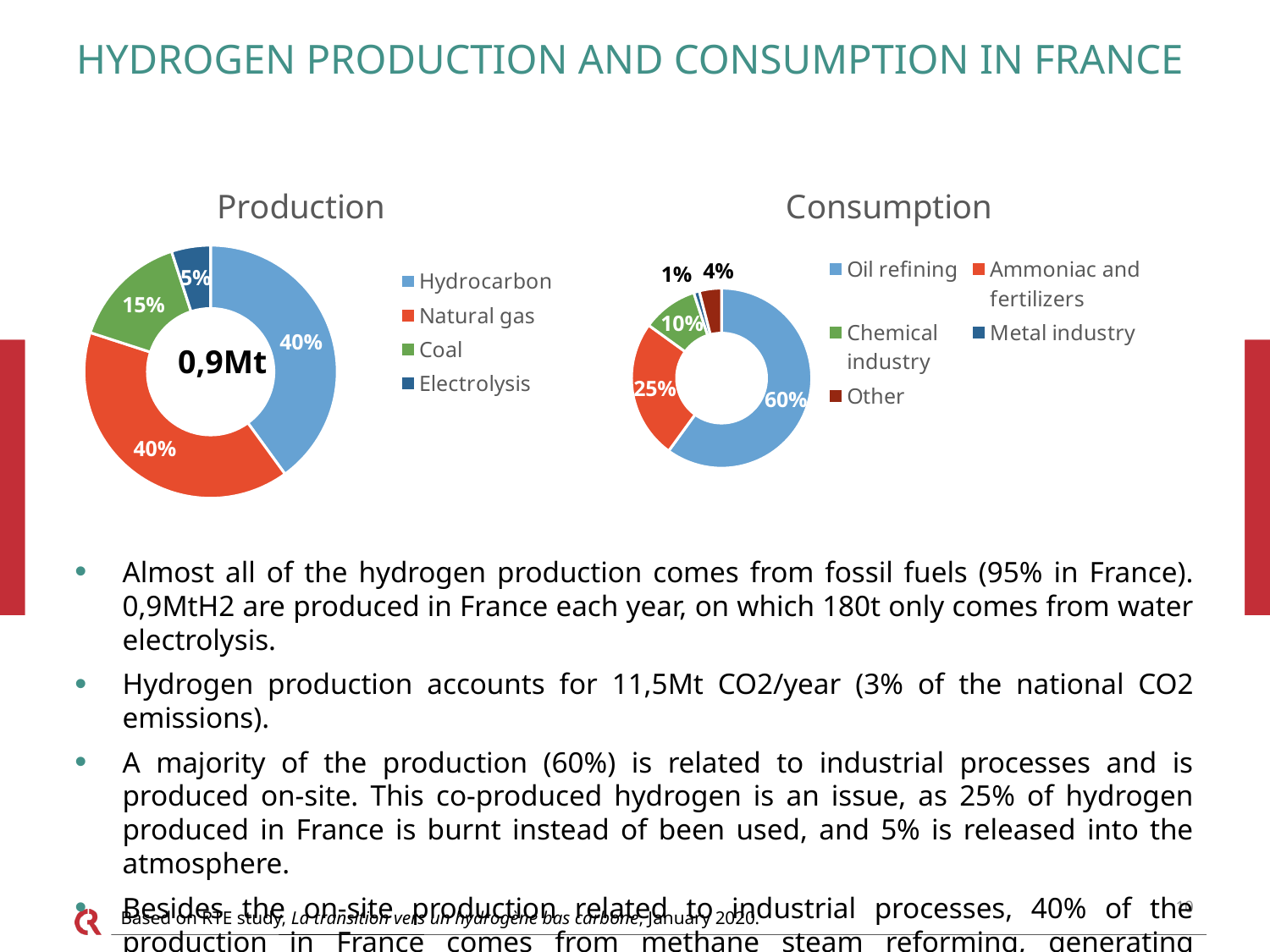
In the Consumption chart, what share goes to Oil refining? 60% In the Consumption chart, which category has the largest share? Oil refining In the Production chart, what share comes from Electrolysis? 5% In the Production chart, which source has the smallest share? Electrolysis What kind of chart is the Consumption chart? doughnut chart In the Production chart, what share comes from Coal? 15% In the Consumption chart, which is larger: Chemical industry or Other? Chemical industry In the Production chart, what total quantity is shown in the centre of the doughnut? 0,9Mt In the Consumption chart, what share goes to Ammoniac and fertilizers? 25% In the Production chart, what is the difference between the Coal share and the Electrolysis share? 10% In the Consumption chart, which category has the smallest share? Metal industry In the Production chart, how many sources does the legend list? 4